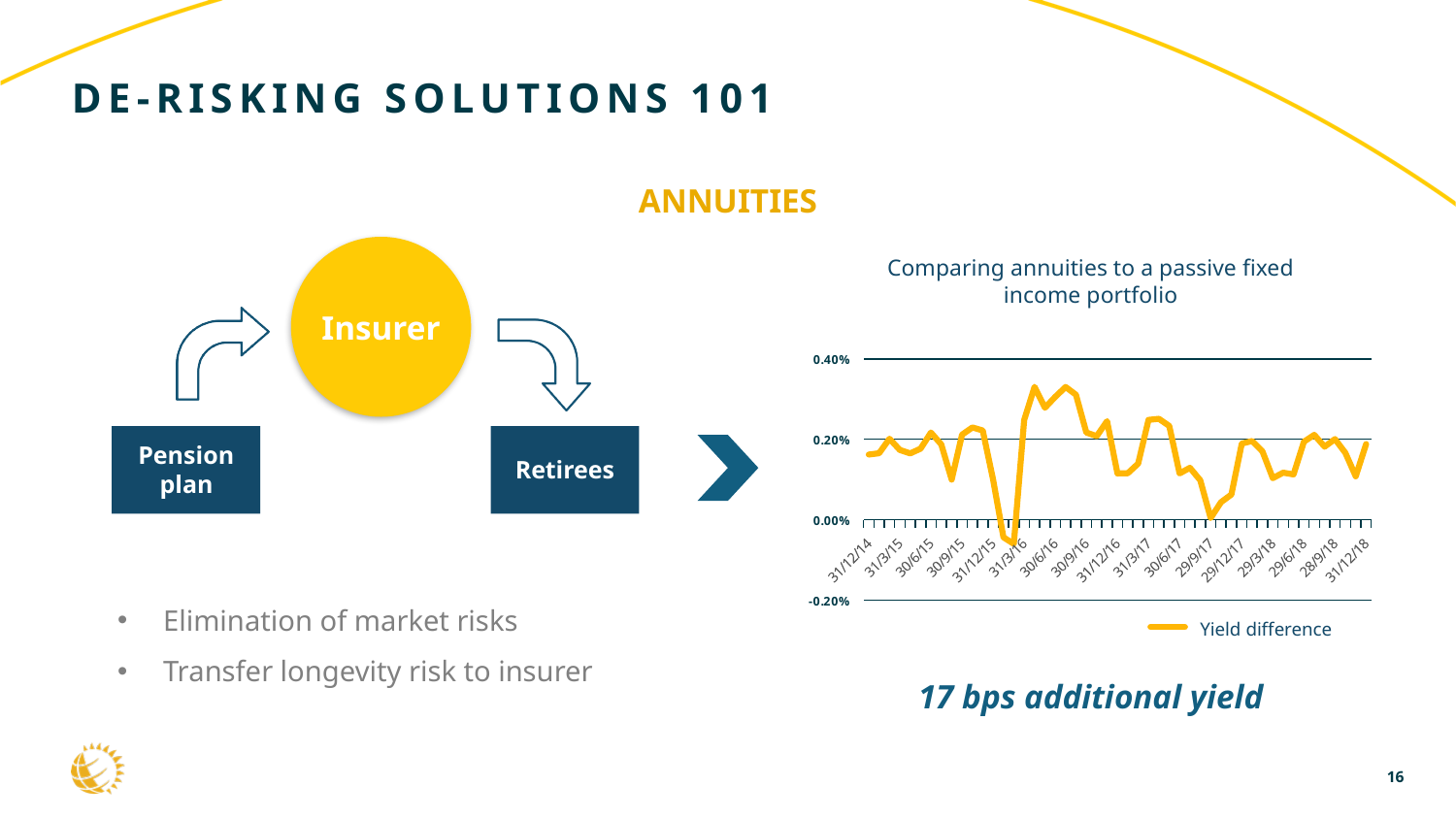
What series name appears in the chart's legend? Yield difference Is the value of the yield difference at 30/6/16 greater or less than 0.20%? greater Is the value of the yield difference at 31/12/14 greater or less than 0.20%? less Is the highest point of the yield difference line greater or less than 0.20%? greater What is the title of the chart on the slide? Comparing annuities to a passive fixed income portfolio What is the first date label on the chart's horizontal axis? 31/12/14 How many series does the chart's legend list? 1 What kind of chart is shown on the slide? Line chart What is the last date label on the chart's horizontal axis? 31/12/18 What is the highest value shown on the chart's vertical axis? 0.40%